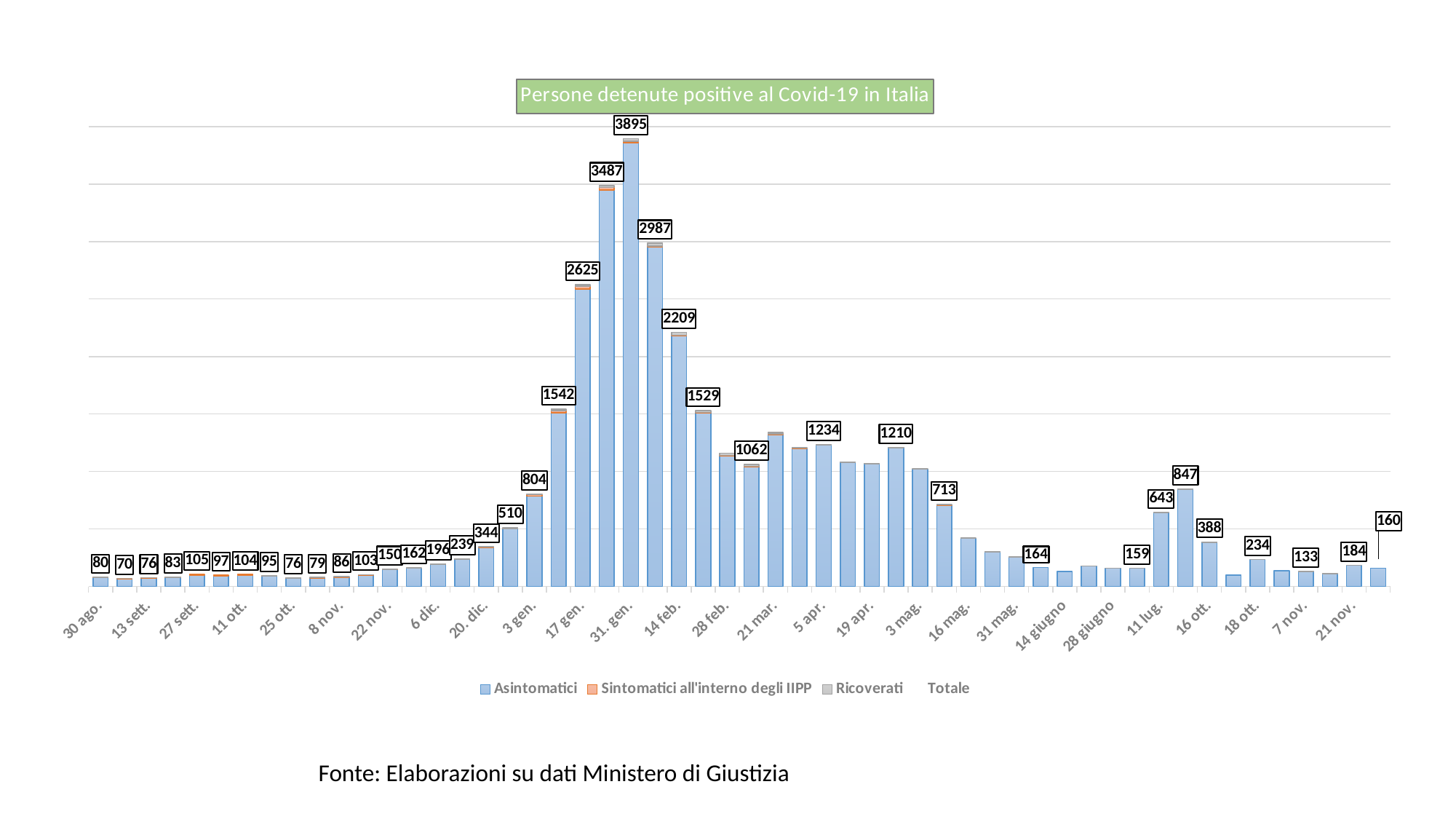
What is the title of the chart? Persone detenute positive al Covid-19 in Italia What is the total value labelled for 11 lug.? 643 What is the total value labelled for 31. gen.? 3895 What is the difference between the totals for 31. gen. and 17 gen.? 1270 What is the total value labelled for 14 feb.? 2209 What kind of chart is shown on the slide? Stacked bar chart Which date has the highest total? 31. gen. What is the total value labelled for 30 ago.? 80 Which has a larger total, 11 lug. or 16 ott.? 11 lug. How many series does the legend list? 4 What is the total value labelled for 17 gen.? 2625 Do the totals rise or fall from 3 gen. to 31. gen.? Rise